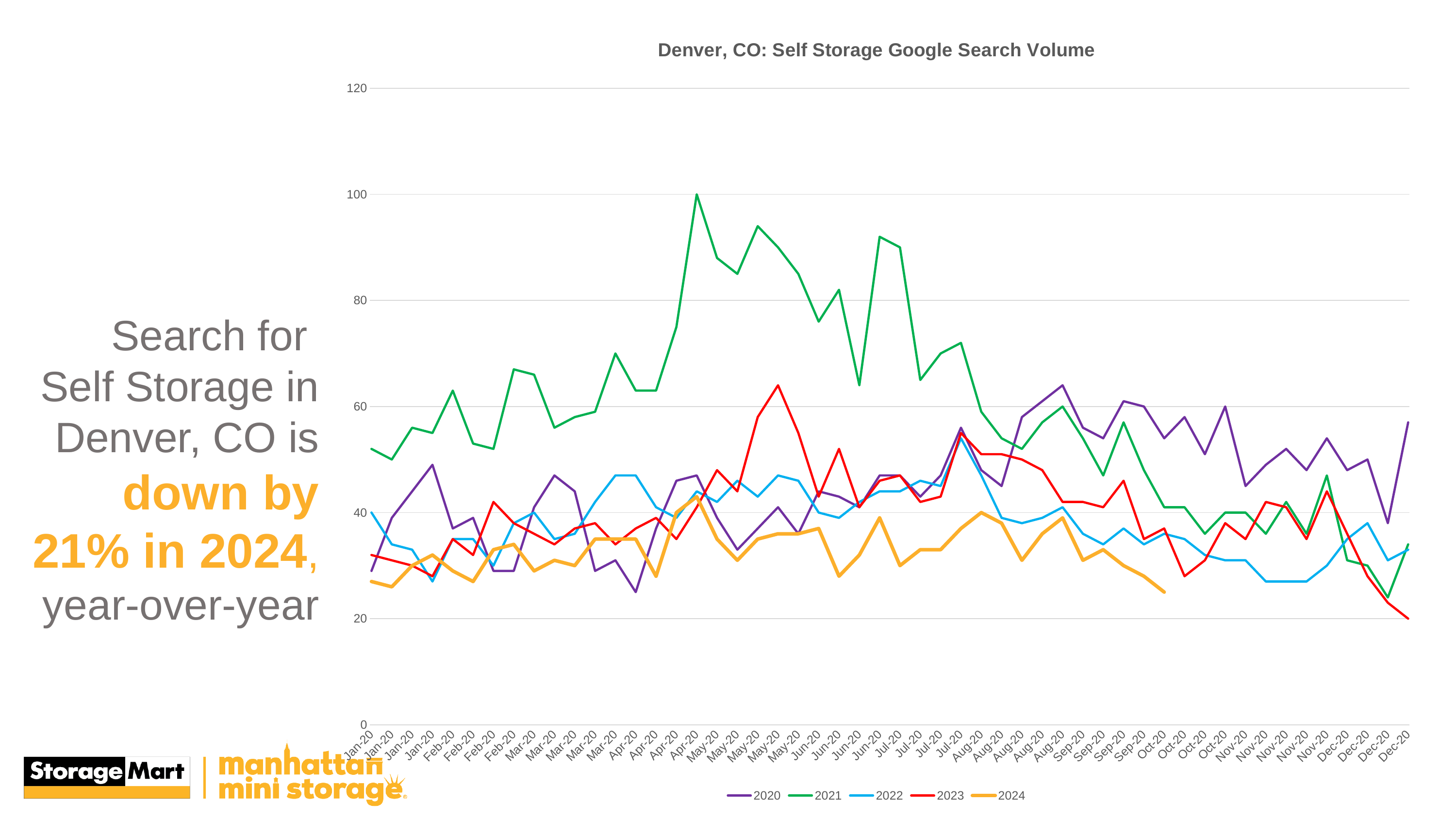
Around Apr-20 to Jul-20, which series is higher: 2021 or 2024? 2021 What is the highest value shown on the vertical axis? 120 Which series reaches the highest value on the chart? 2021 What kind of chart is shown on the slide? line chart Is the last plotted value of the 2020 series (Dec-20) greater or less than 40? greater Which colour is used for the 2024 series in the legend? orange How many series does the legend list? 5 Which series ends earliest on the x axis, stopping around Oct-20? 2024 Is the highest value of the 2024 series greater or less than 60? less Is the last plotted value of the 2023 series (Dec-20) greater or less than 40? less